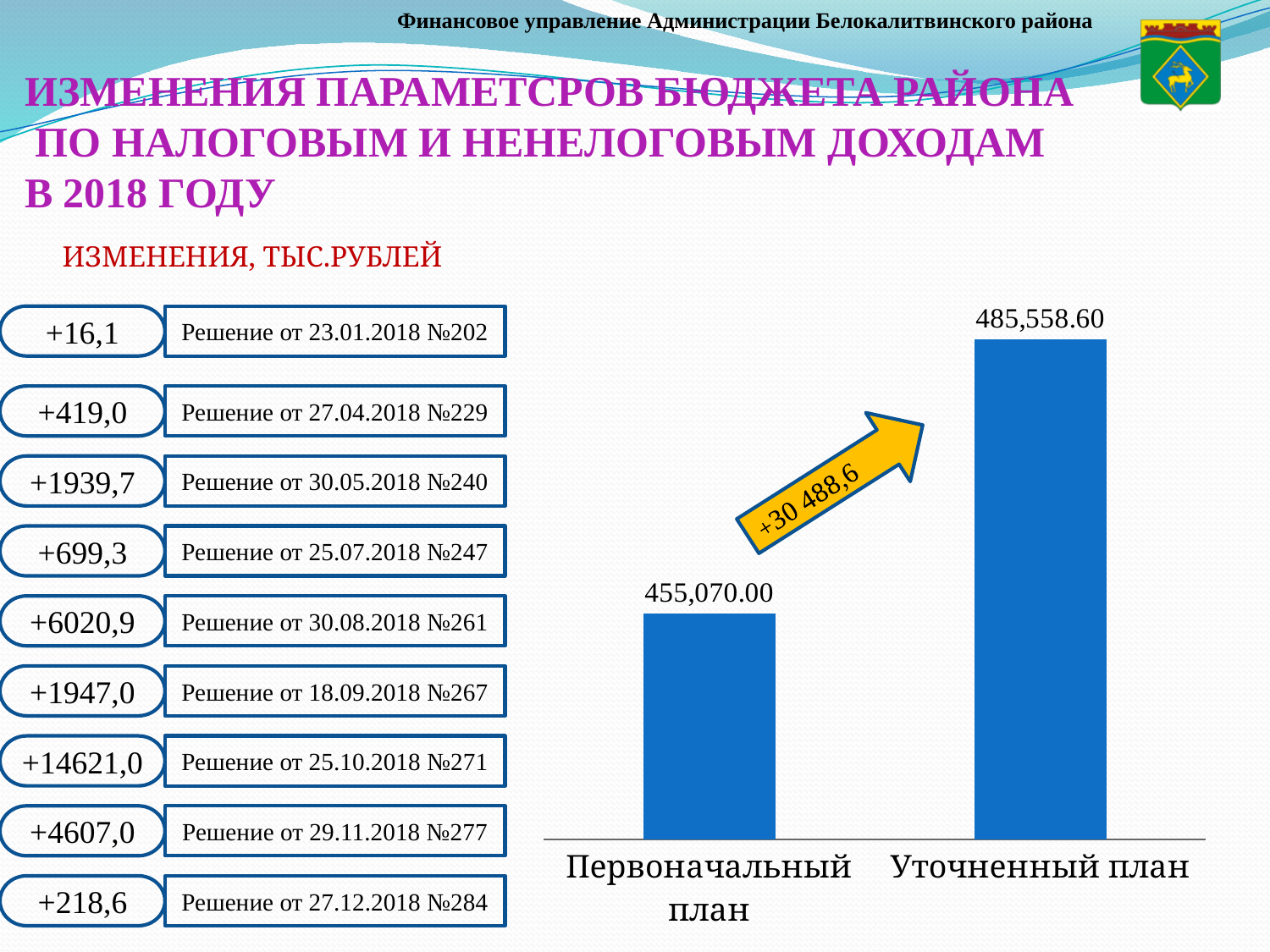
Which is larger, Первоначальный план or Уточненный план? Уточненный план What colour are the bars in the chart? Blue What is the difference between Уточненный план and Первоначальный план? 30,488.60 Which category has the lowest value? Первоначальный план Do the values rise or fall from Первоначальный план to Уточненный план? Rise What kind of chart is shown on the slide? Bar chart What is the value for Первоначальный план? 455,070.00 Which category has the highest value? Уточненный план What is the value for Уточненный план? 485,558.60 How many bars are shown in the chart? 2 What change is written on the arrow between the two bars? +30 488,6